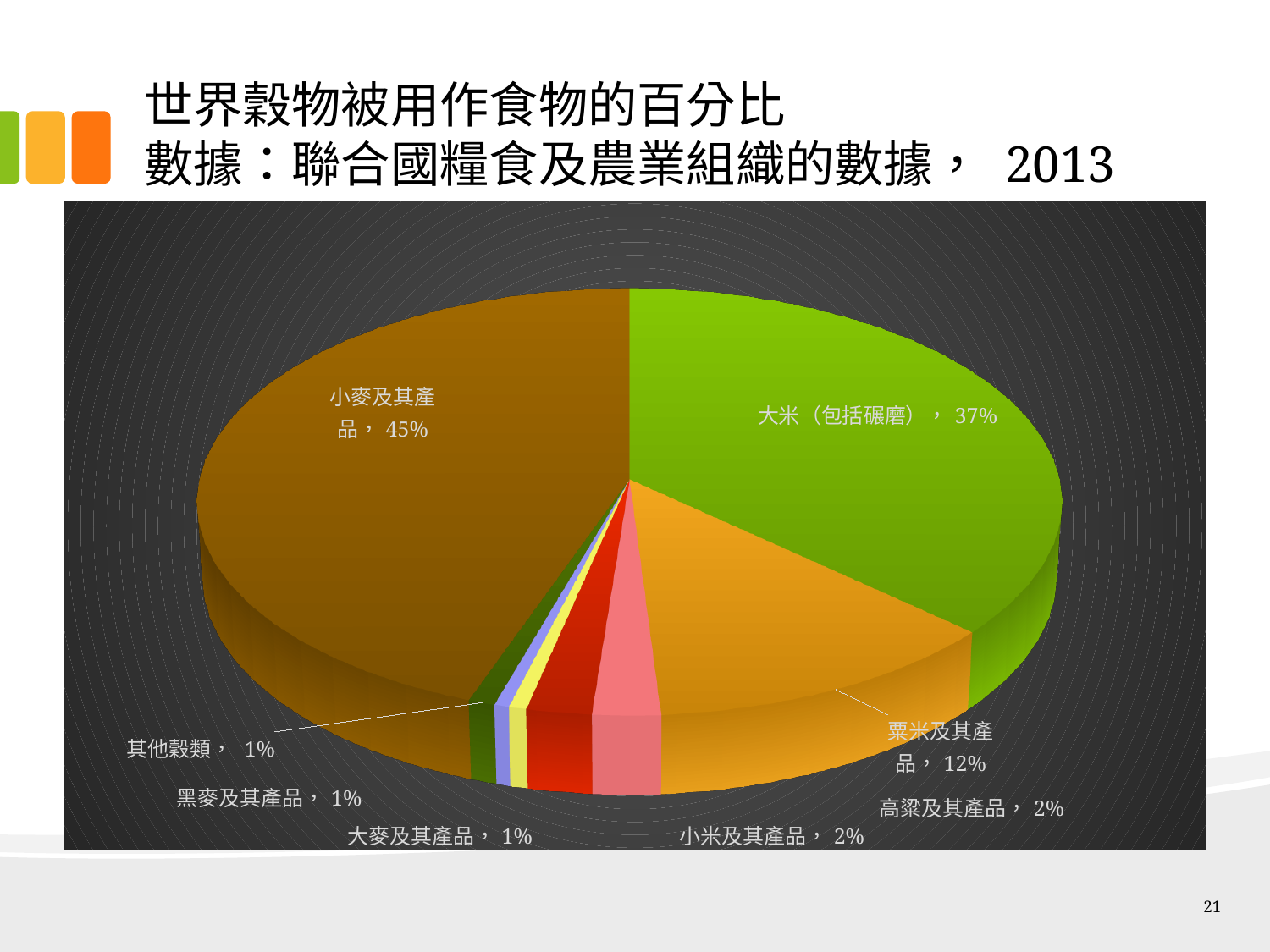
What percentage is shown for 小麥及其產品? 45% What percentage is shown for 高粱及其產品? 2% How many categories (slices) are labelled in the pie chart? 8 Which is larger, the share for 粟米及其產品 or the share for 小米及其產品? 粟米及其產品 What is the title of the chart on the slide? 世界穀物被用作食物的百分比 What is the combined share of 高粱及其產品 and 小米及其產品? 4% What is the difference in percentage points between 小麥及其產品 and 大米（包括碾磨）? 8 What percentage is shown for 黑麥及其產品? 1% What percentage is shown for 粟米及其產品? 12% What percentage is shown for 大米（包括碾磨）? 37% What kind of chart is shown on the slide? pie chart Which category has the largest share of the pie? 小麥及其產品